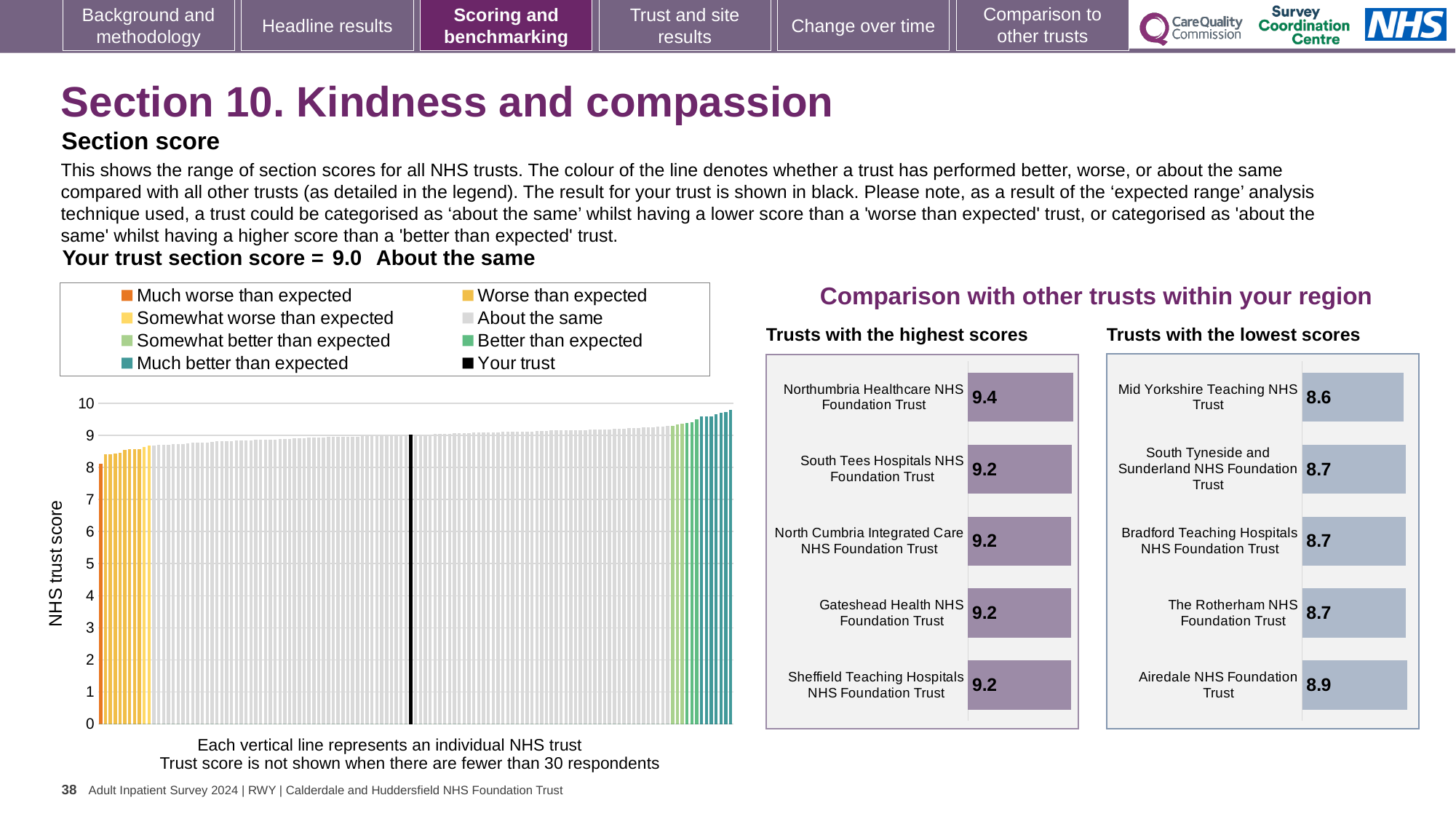
In the large chart on the left, is the value of the leftmost bar greater or less than 9? less What kind of chart is the large chart on the left showing NHS trust scores? bar chart What is your trust's section score for Kindness and compassion, as stated on the slide? 9.0 In the 'Trusts with the lowest scores' chart, what is the difference between the scores of Airedale NHS Foundation Trust and Mid Yorkshire Teaching NHS Trust? 0.3 In the 'Trusts with the lowest scores' chart, which trust has the lowest score? Mid Yorkshire Teaching NHS Trust In the 'Trusts with the highest scores' chart, how many trusts are shown? 5 How many entries does the legend of the large chart on the left list? 8 In the 'Trusts with the highest scores' chart, what is the difference between the scores of Northumbria Healthcare NHS Foundation Trust and Gateshead Health NHS Foundation Trust? 0.2 In the large chart on the left, do the trust scores rise or fall from left to right? rise In the 'Trusts with the highest scores' chart, which trust has the highest score? Northumbria Healthcare NHS Foundation Trust In the 'Trusts with the highest scores' chart, what is the score for South Tees Hospitals NHS Foundation Trust? 9.2 In the 'Trusts with the lowest scores' chart, what is the score for Airedale NHS Foundation Trust? 8.9